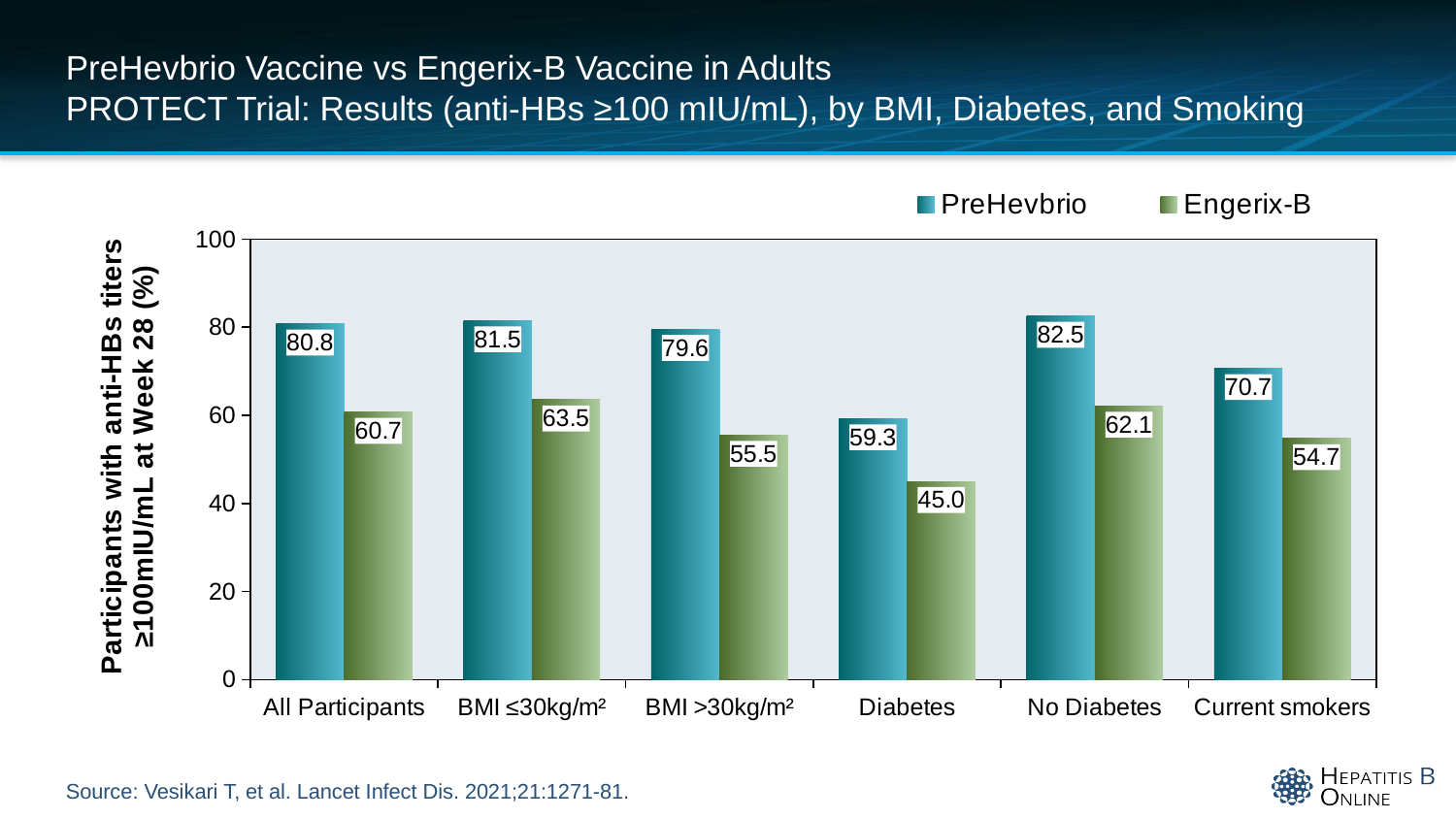
What is the label of the y axis? Participants with anti-HBs titers ≥100mIU/mL at Week 28 (%) Which category has the highest PreHevbrio value? No Diabetes How many series does the legend list? 2 Which category has the lowest Engerix-B value? Diabetes What is the difference between the PreHevbrio and Engerix-B values for BMI >30kg/m²? 24.1 Is the Engerix-B value for No Diabetes greater or less than 60? greater Which is larger for the Diabetes group, the PreHevbrio value or the Engerix-B value? PreHevbrio What is the Engerix-B value for Current smokers? 54.7 What kind of chart is shown on the slide? Bar chart What is the PreHevbrio value for All Participants? 80.8 What is the Engerix-B value for the Diabetes group? 45.0 How many categories are shown on the x axis? 6